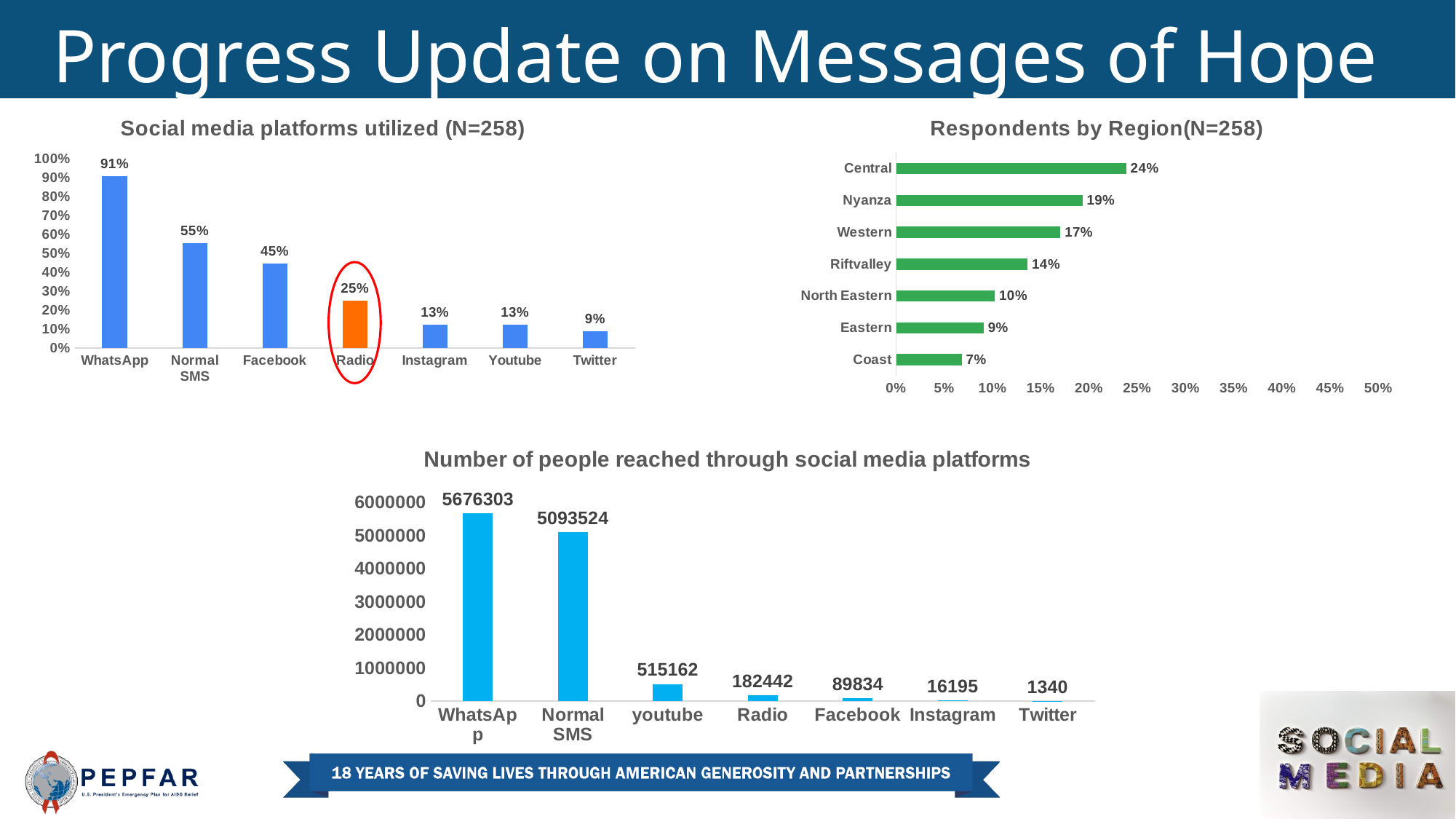
In the 'Social media platforms utilized (N=258)' chart, what is the value for Radio? 25% In the 'Number of people reached through social media platforms' chart, which platform has the lowest value? Twitter In the 'Number of people reached through social media platforms' chart, what is the value for Normal SMS? 5093524 In the 'Respondents by Region(N=258)' chart, which region has the lowest value? Coast What kind of chart is 'Respondents by Region(N=258)'? Bar chart In the 'Social media platforms utilized (N=258)' chart, how many platforms are shown? 7 In the 'Social media platforms utilized (N=258)' chart, what is the difference between WhatsApp and Normal SMS? 36% In the 'Social media platforms utilized (N=258)' chart, which platform has the highest value? WhatsApp In the 'Respondents by Region(N=258)' chart, what is the value for Nyanza? 19% In the 'Respondents by Region(N=258)' chart, which is larger, Western or Riftvalley? Western In the 'Number of people reached through social media platforms' chart, what is the difference between WhatsApp and Normal SMS? 582779 In the 'Social media platforms utilized (N=258)' chart, which bar is coloured orange and circled in red? Radio